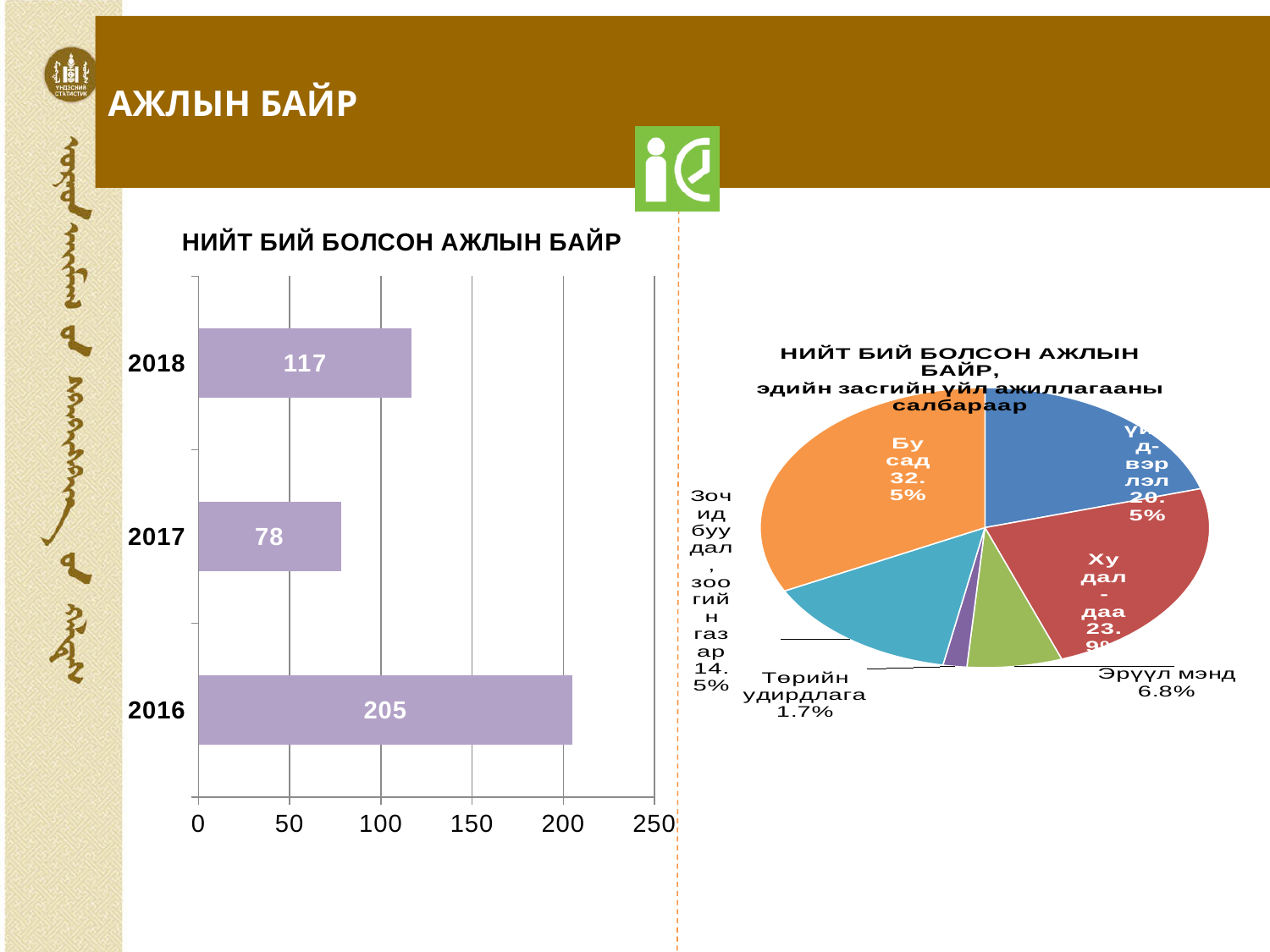
What kind of chart is the chart on the right of the slide? Pie chart In the pie chart on the right, what share does 'Эрүүл мэнд' have? 6.8% What kind of chart is the chart on the left of the slide? Bar chart In the bar chart 'НИЙТ БИЙ БОЛСОН АЖЛЫН БАЙР', which year has the lowest value? 2017 How many years are shown in the bar chart 'НИЙТ БИЙ БОЛСОН АЖЛЫН БАЙР'? 3 In the bar chart 'НИЙТ БИЙ БОЛСОН АЖЛЫН БАЙР', what is the value for 2016? 205 In the pie chart on the right, what share does 'Төрийн удирдлага' have? 1.7% In the bar chart 'НИЙТ БИЙ БОЛСОН АЖЛЫН БАЙР', what is the value for 2017? 78 In the bar chart 'НИЙТ БИЙ БОЛСОН АЖЛЫН БАЙР', which year has the highest value? 2016 In the bar chart 'НИЙТ БИЙ БОЛСОН АЖЛЫН БАЙР', what is the value for 2018? 117 In the bar chart 'НИЙТ БИЙ БОЛСОН АЖЛЫН БАЙР', which is larger, the value for 2017 or 2018? 2018 In the bar chart 'НИЙТ БИЙ БОЛСОН АЖЛЫН БАЙР', what is the difference between the values for 2016 and 2018? 88